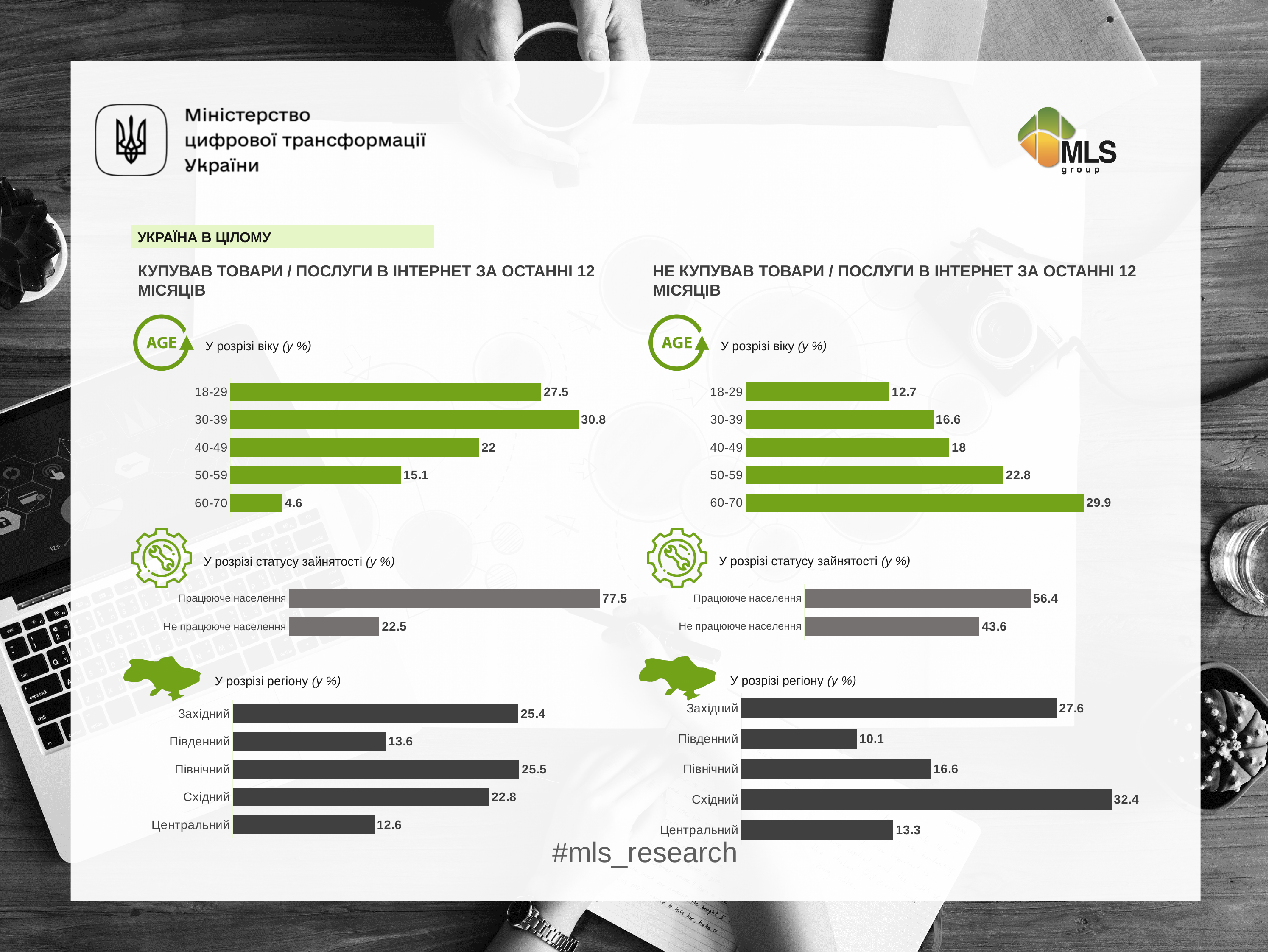
In the left-hand region chart (КУПУВАВ), which region has the lowest value? Центральний In the left-hand age chart (КУПУВАВ), do the values rise or fall from the 30-39 group to the 60-70 group? fall In the age chart under 'КУПУВАВ ТОВАРИ / ПОСЛУГИ В ІНТЕРНЕТ ЗА ОСТАННІ 12 МІСЯЦІВ' (left), what is the value for the 30-39 age group? 30.8 In the left-hand age chart (КУПУВАВ), which age group has the lowest value? 60-70 What type of chart is used for the region breakdown on the right-hand side (НЕ КУПУВАВ)? bar chart In the right-hand region chart (НЕ КУПУВАВ), which region has the highest value? Східний How many age groups are shown in the left-hand age chart (КУПУВАВ)? 5 In the left-hand employment status chart (КУПУВАВ), what is the difference between 'Працююче населення' and 'Не працююче населення'? 55 In the right-hand employment status chart (НЕ КУПУВАВ), what is the value for 'Не працююче населення'? 43.6 In the left-hand region chart (КУПУВАВ), which is larger: the value for Західний or the value for Південний? Західний In the age chart under 'НЕ КУПУВАВ ТОВАРИ / ПОСЛУГИ В ІНТЕРНЕТ ЗА ОСТАННІ 12 МІСЯЦІВ' (right), which age group has the highest value? 60-70 In the right-hand age chart (НЕ КУПУВАВ), what is the value for the 18-29 age group? 12.7